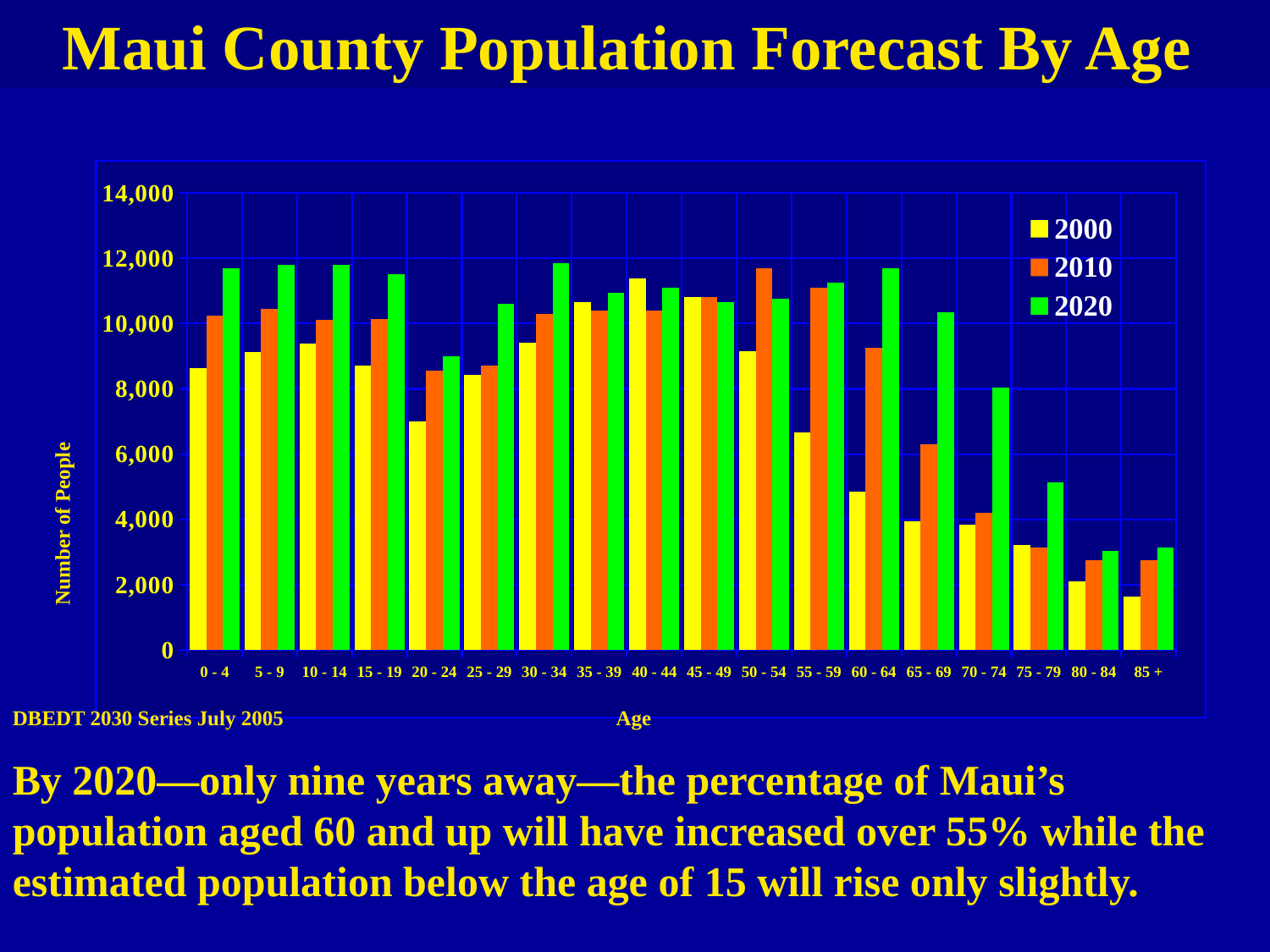
Is the value for 2000 in the 85 + age group greater or less than 2,000? less What is the title of the y axis? Number of People Is the value for 2010 in the 60 - 64 age group greater or less than 8,000? greater Do the 2000 series values rise or fall from the 60 - 64 age group to the 85 + age group? fall Which age group has the highest value for the 2000 series? 40 - 44 Which age group has the lowest value for the 2000 series? 85 + How many series does the legend list? 3 Is the value for 2000 in the 60 - 64 age group greater or less than 4,000? greater What kind of chart is shown on the slide? bar chart How many age groups are shown on the x axis? 18 For the 65 - 69 age group, which is larger, the 2000 value or the 2020 value? 2020